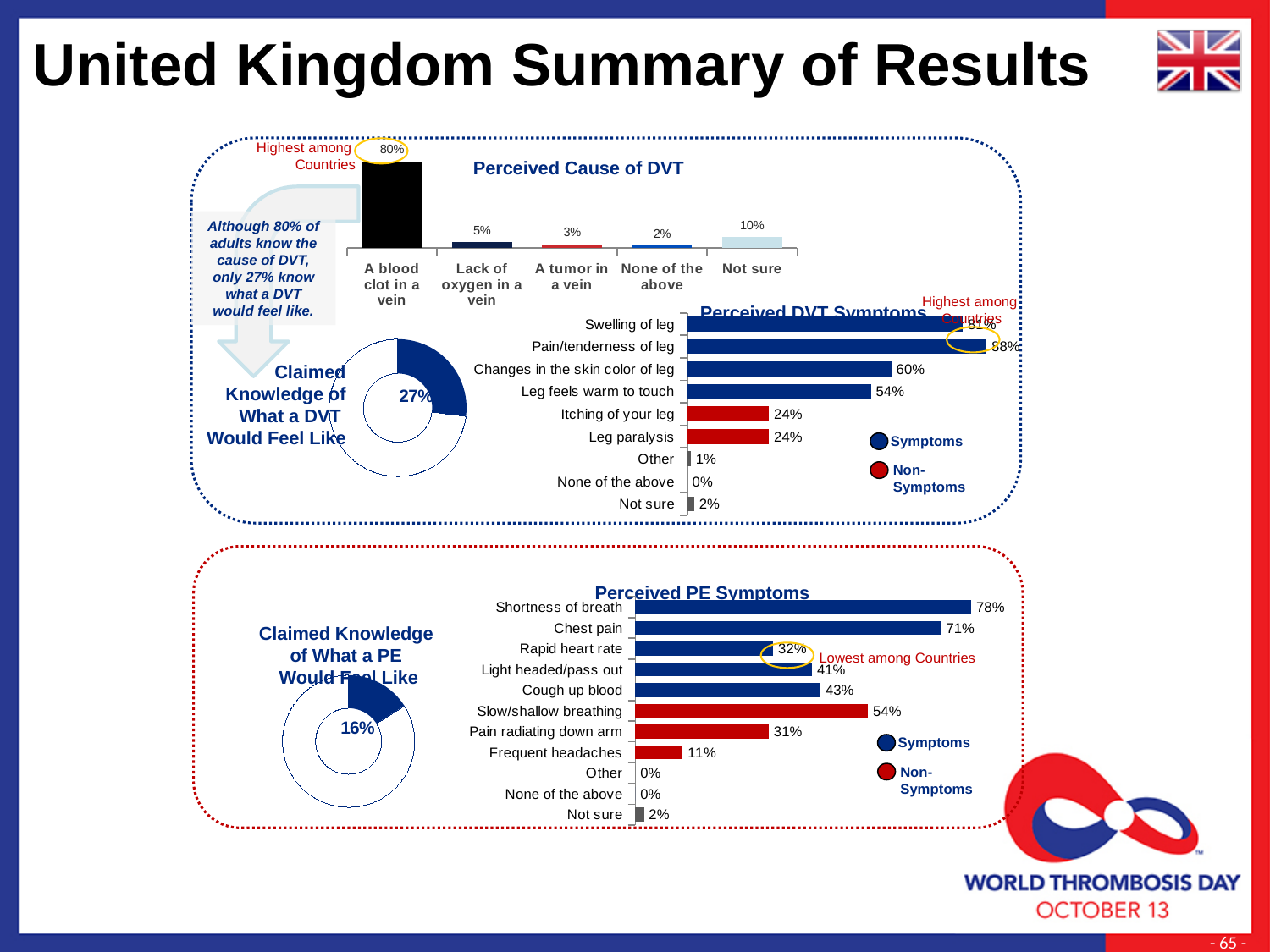
What percentage is shown in the 'Claimed Knowledge of What a DVT Would Feel Like' donut chart? 27% In the Perceived Cause of DVT chart, what is the difference between 'Lack of oxygen in a vein' and 'A tumor in a vein'? 2% In the Perceived PE Symptoms chart, which symptom has the highest value? Shortness of breath In the Perceived Cause of DVT chart, what percentage is shown for 'Not sure'? 10% In the Perceived DVT Symptoms chart, what percentage is shown for 'Changes in the skin color of leg'? 60% In the Perceived DVT Symptoms chart, what is the difference between 'Leg feels warm to touch' and 'Itching of your leg'? 30% In the Perceived Cause of DVT chart, what percentage is shown for 'A blood clot in a vein'? 80% In the Perceived Cause of DVT chart, how many categories are shown? 5 What type of chart is the Perceived PE Symptoms chart? Bar chart In the Perceived Cause of DVT chart, which category has the lowest value? None of the above In the Perceived PE Symptoms chart, which is larger: 'Cough up blood' or 'Light headed/pass out'? Cough up blood What percentage is shown in the 'Claimed Knowledge of What a PE Would Feel Like' donut chart? 16%